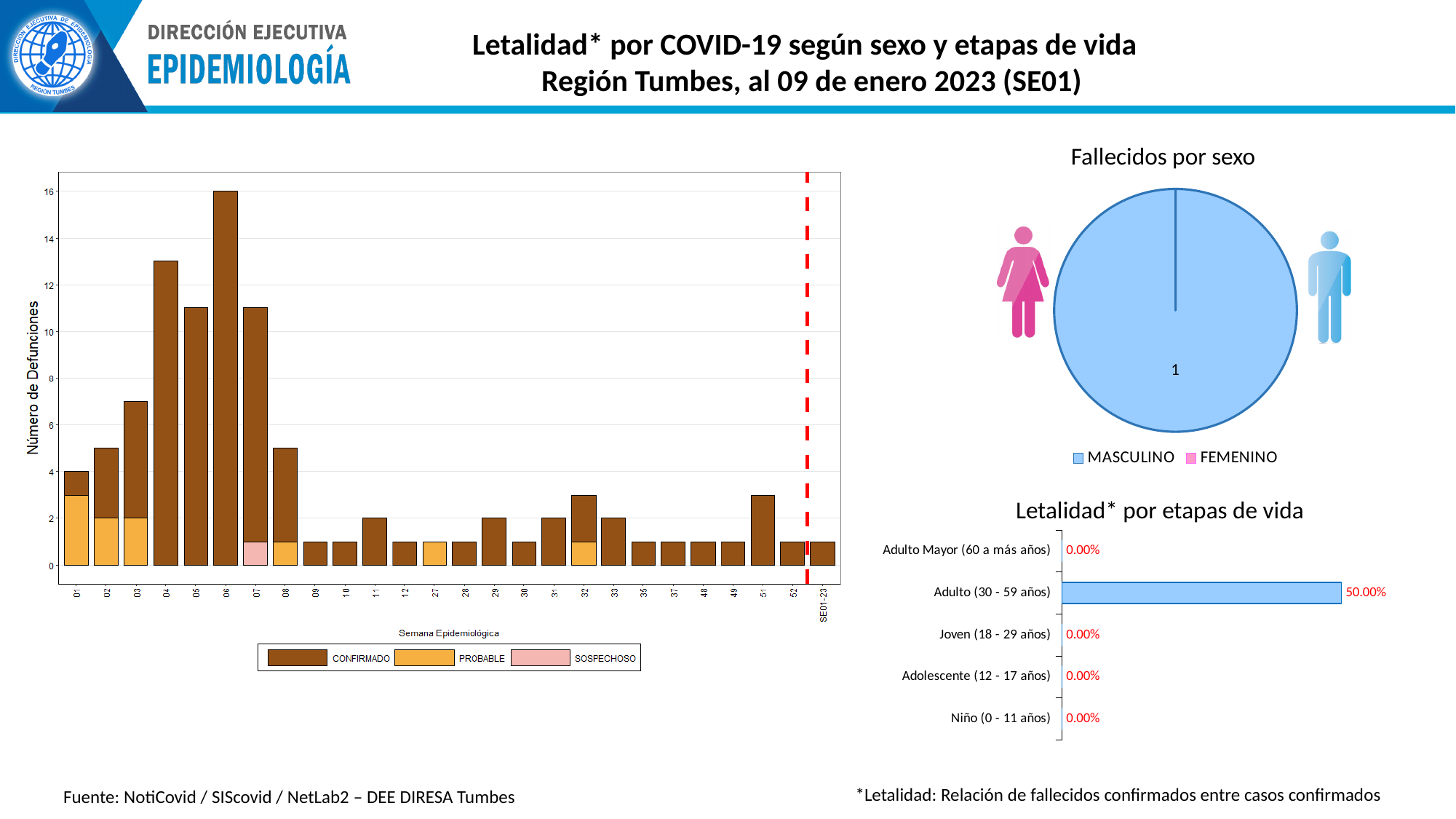
In the chart 'Letalidad* por etapas de vida', what is the difference between the values for Adulto (30 - 59 años) and Joven (18 - 29 años)? 50.00% In the bar chart on the left (Número de Defunciones by Semana Epidemiológica), which week has the highest total number of deaths? 06 In the chart 'Letalidad* por etapas de vida', how many age groups are shown? 5 How many series does the legend of the bar chart on the left (Número de Defunciones) list? 3 In the bar chart on the left (Número de Defunciones by Semana Epidemiológica), is the total for week 04 greater or less than 12? greater In the chart 'Letalidad* por etapas de vida', what is the value for Adulto (30 - 59 años)? 50.00% How many entries does the legend of the pie chart 'Fallecidos por sexo' list? 2 In the chart 'Letalidad* por etapas de vida', which age group has the highest value? Adulto (30 - 59 años) In the pie chart 'Fallecidos por sexo', what value is printed for MASCULINO? 1 What kind of chart is 'Letalidad* por etapas de vida'? Bar chart What kind of chart is 'Fallecidos por sexo'? Pie chart In the chart 'Letalidad* por etapas de vida', what is the value for Adulto Mayor (60 a más años)? 0.00%